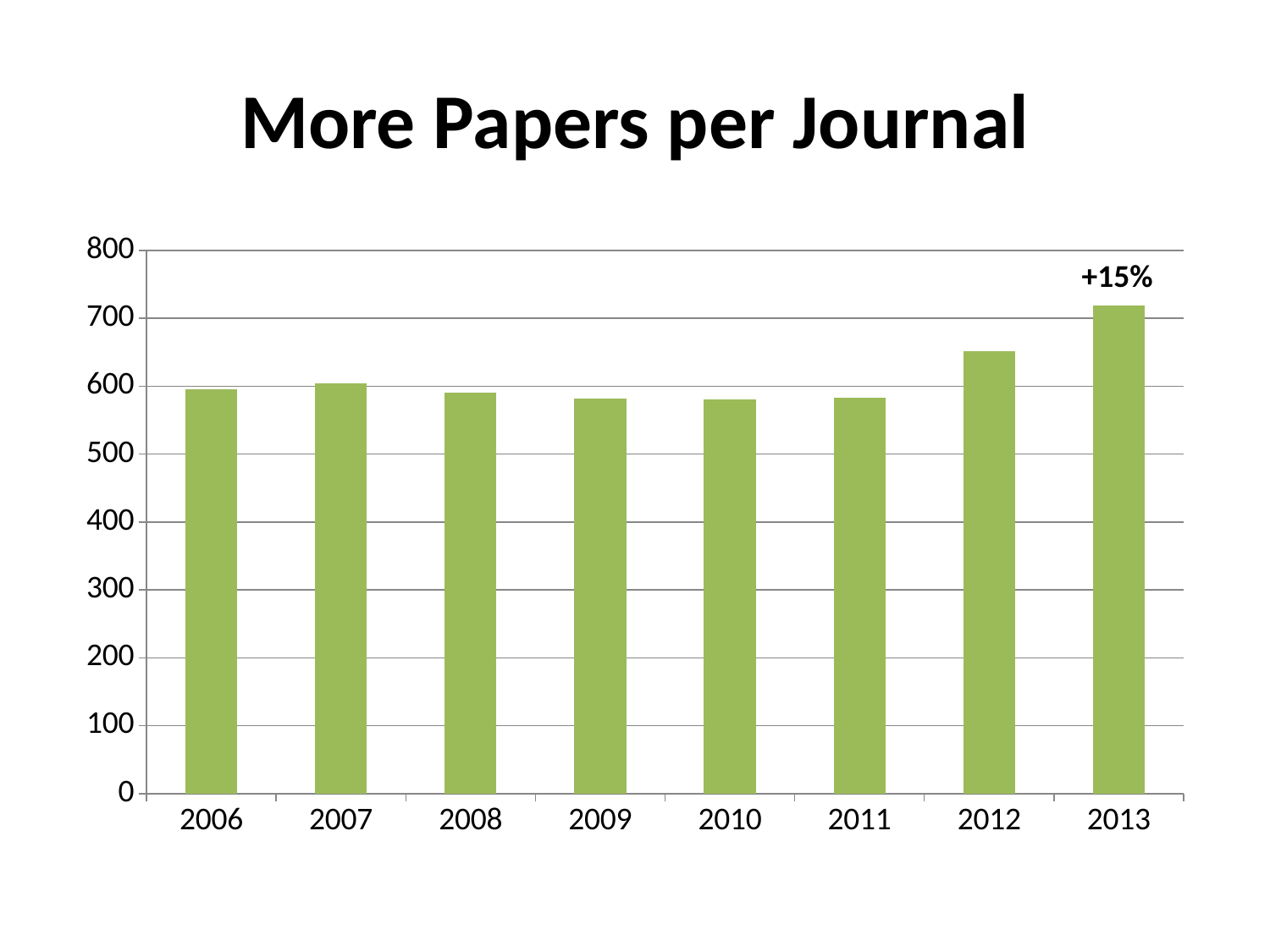
Is the value for 2009 greater or less than 600? less Is the value for 2013 greater or less than 700? greater Is the value for 2012 greater or less than 600? greater What kind of chart is shown on the slide? bar chart Which is larger, the value for 2006 or the value for 2012? 2012 What annotation is printed above the 2013 bar? +15% Do the values rise or fall from 2011 to 2013? rise Which is larger, the value for 2012 or the value for 2013? 2013 How many years are shown on the x axis of the chart? 8 Which year has the highest bar in the chart? 2013